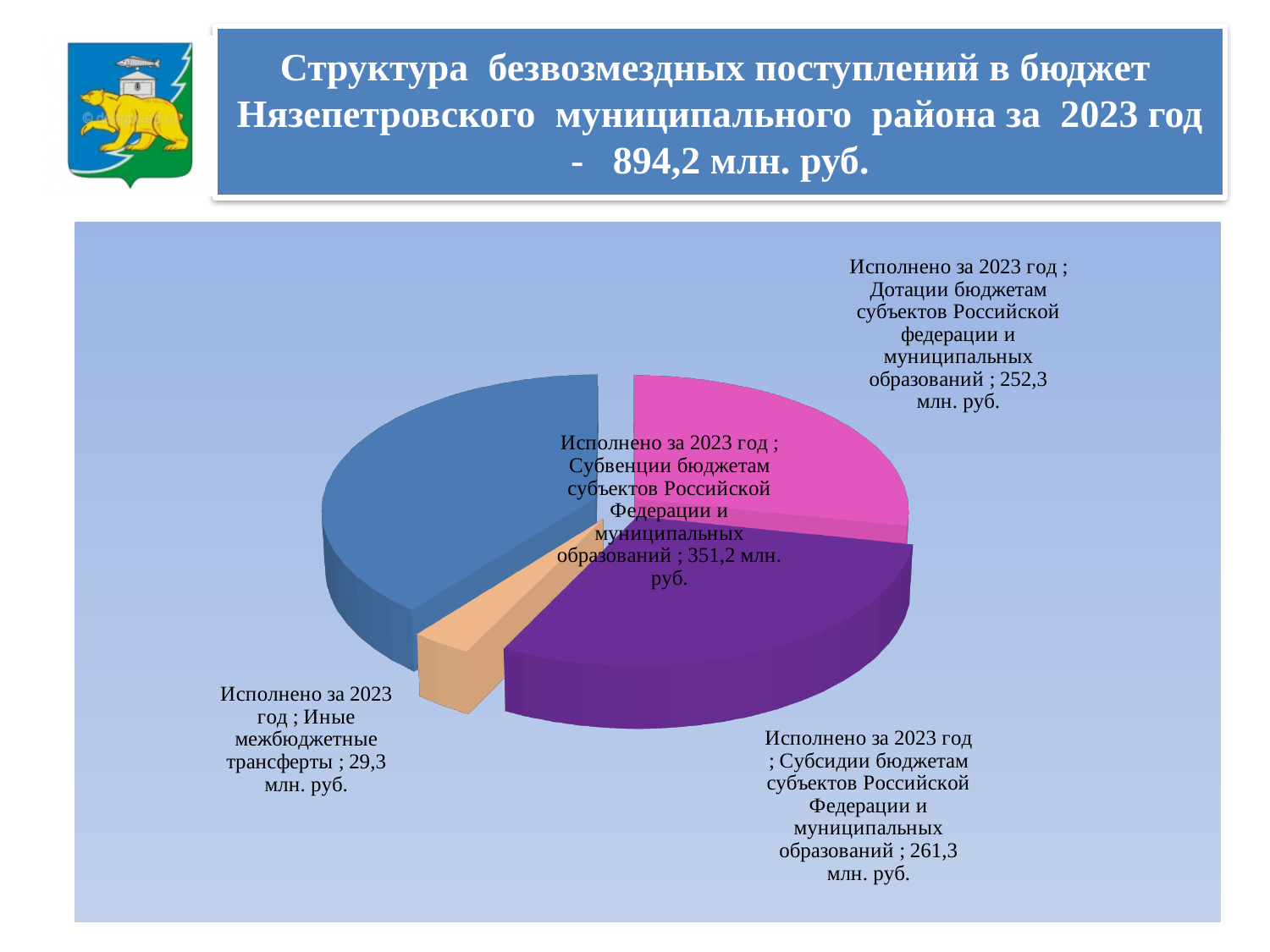
Which is larger, the value for Субсидии or the value for Иные межбюджетные трансферты? Субсидии What kind of chart is shown on the slide? Pie chart What is the value for Субвенции бюджетам субъектов Российской Федерации и муниципальных образований? 351,2 млн. руб. What colour is the slice for Иные межбюджетные трансферты? Orange What is the value for Иные межбюджетные трансферты? 29,3 млн. руб. What is the difference between the values for Субсидии and Дотации? 9,0 млн. руб. What is the value for Дотации бюджетам субъектов Российской федерации и муниципальных образований? 252,3 млн. руб. What is the difference between the values for Субвенции and Дотации? 98,9 млн. руб. Which category has the largest slice of the pie? Субвенции бюджетам субъектов Российской Федерации и муниципальных образований How many slices does the pie chart have? 4 Which category has the smallest slice of the pie? Иные межбюджетные трансферты What is the value for Субсидии бюджетам субъектов Российской Федерации и муниципальных образований? 261,3 млн. руб.